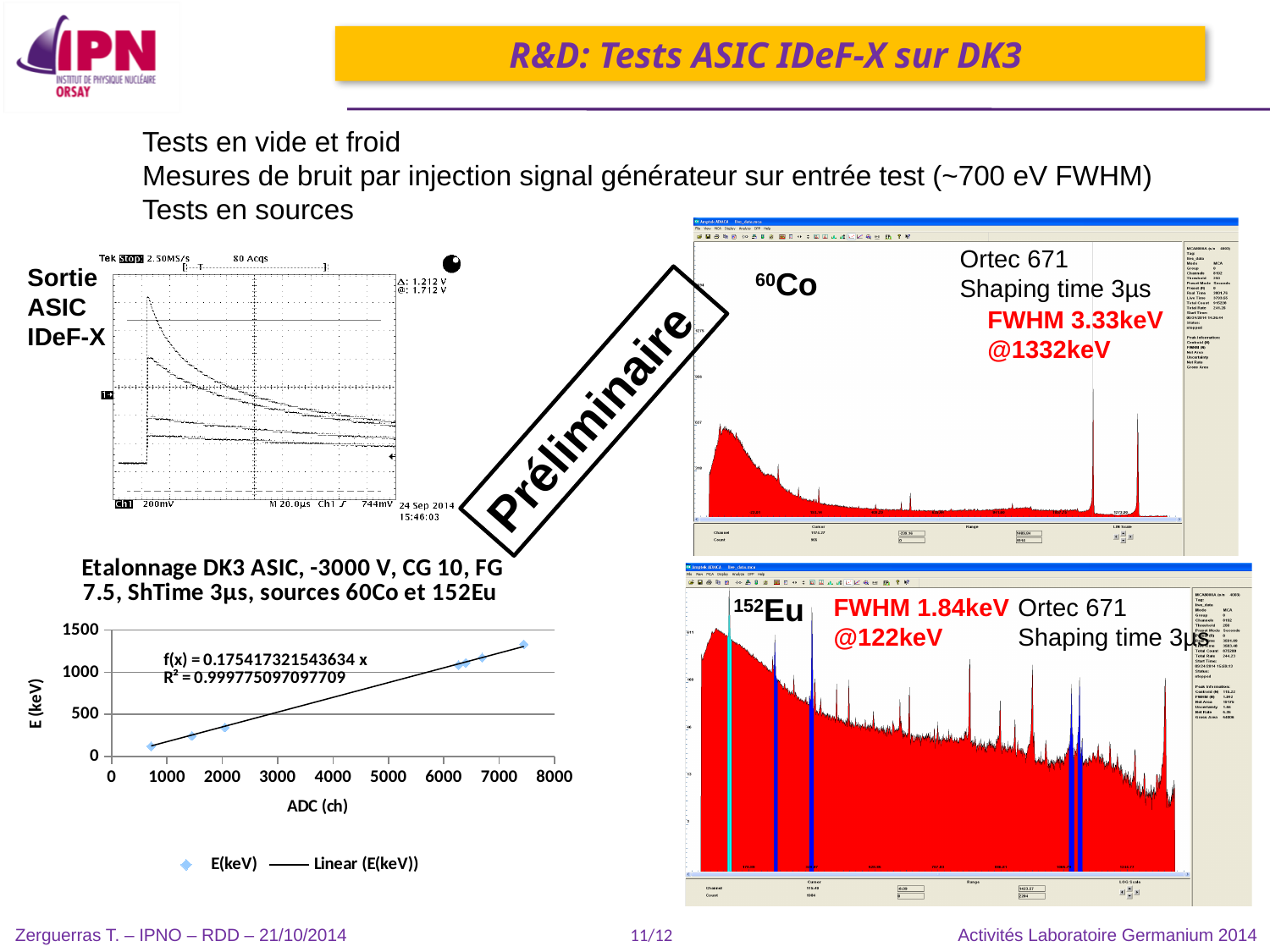
In the 'Etalonnage DK3 ASIC' chart, do the E (keV) values rise or fall as ADC (ch) increases? rise What is the fitted equation f(x) printed on the 'Etalonnage DK3 ASIC' chart? f(x) = 0.175417321543634 x What is the highest tick value shown on the x axis of the 'Etalonnage DK3 ASIC' chart? 8000 In the 'Etalonnage DK3 ASIC' chart, is the E (keV) value of the point near ADC channel 700 greater or less than 500? less In the 'Etalonnage DK3 ASIC' chart, is the E (keV) value of the point with the highest ADC channel greater or less than 1000? greater In the 'Etalonnage DK3 ASIC' chart, is the E (keV) value of the point near ADC channel 2000 greater or less than 500? less In the 'Etalonnage DK3 ASIC' chart, what is the label of the y axis? E (keV) What is the highest tick value shown on the y axis of the 'Etalonnage DK3 ASIC' chart? 1500 In the 'Etalonnage DK3 ASIC' chart, what is the label of the x axis? ADC (ch) How many entries does the legend of the 'Etalonnage DK3 ASIC' chart list? 2 What kind of chart is the 'Etalonnage DK3 ASIC' chart on the lower left of the slide? scatter chart with a linear fit line What R² value is printed on the 'Etalonnage DK3 ASIC' chart? R² = 0.999775097097709